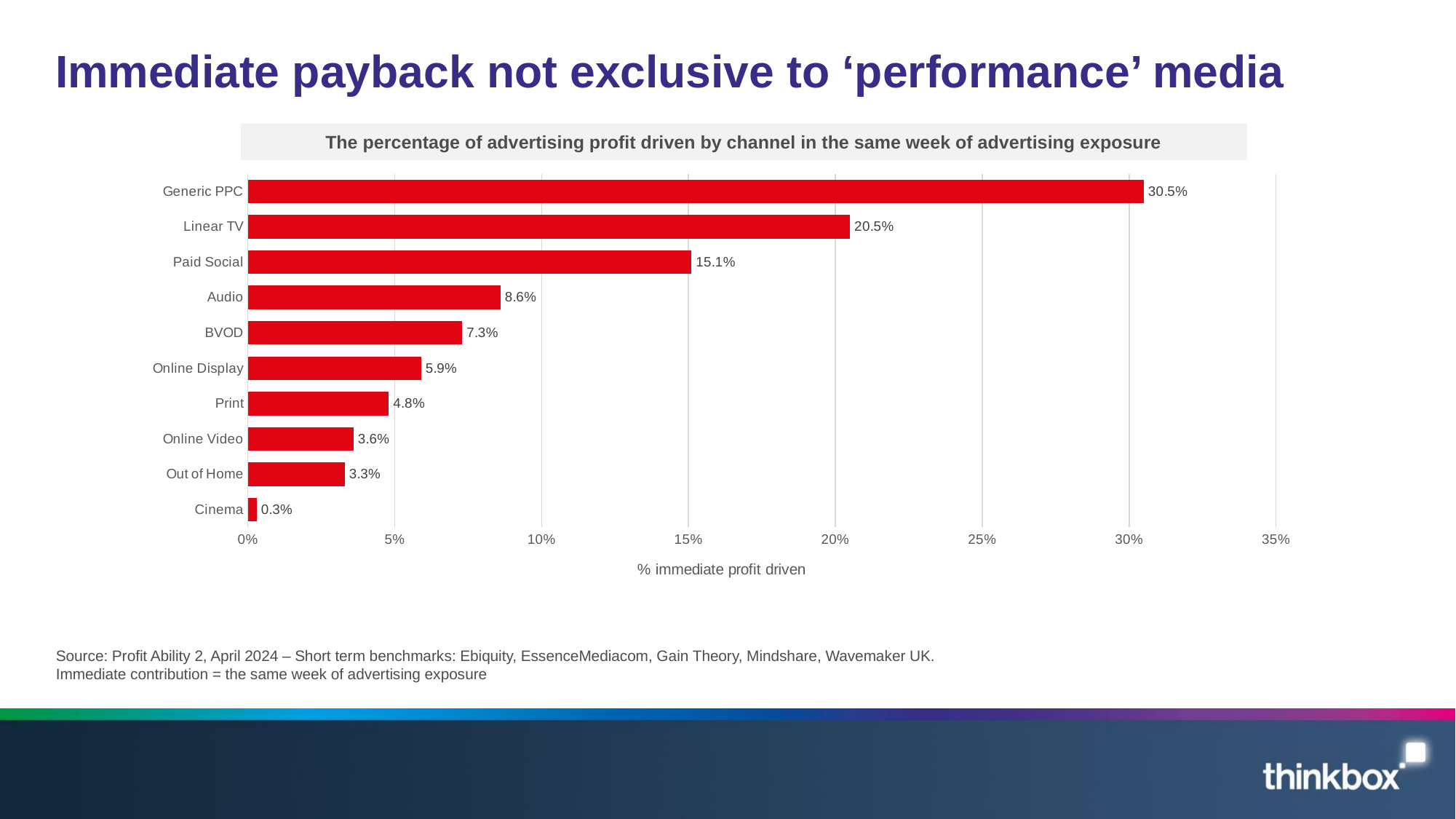
What is the difference between the values for Paid Social and BVOD? 7.8 percentage points What is the label on the horizontal axis of the chart? % immediate profit driven Which channel has the highest percentage of immediate profit driven? Generic PPC How many channels are shown in the chart? 10 Which is larger, the value for Online Display or the value for Print? Online Display What kind of chart is shown on the slide? Bar chart Which channel has the lowest percentage of immediate profit driven? Cinema What is the value for Out of Home? 3.3% Is the value for Paid Social greater or less than 10%? greater What is the difference between the values for Generic PPC and Linear TV? 10 percentage points What is the value for Audio? 8.6% What is the value for Linear TV? 20.5%